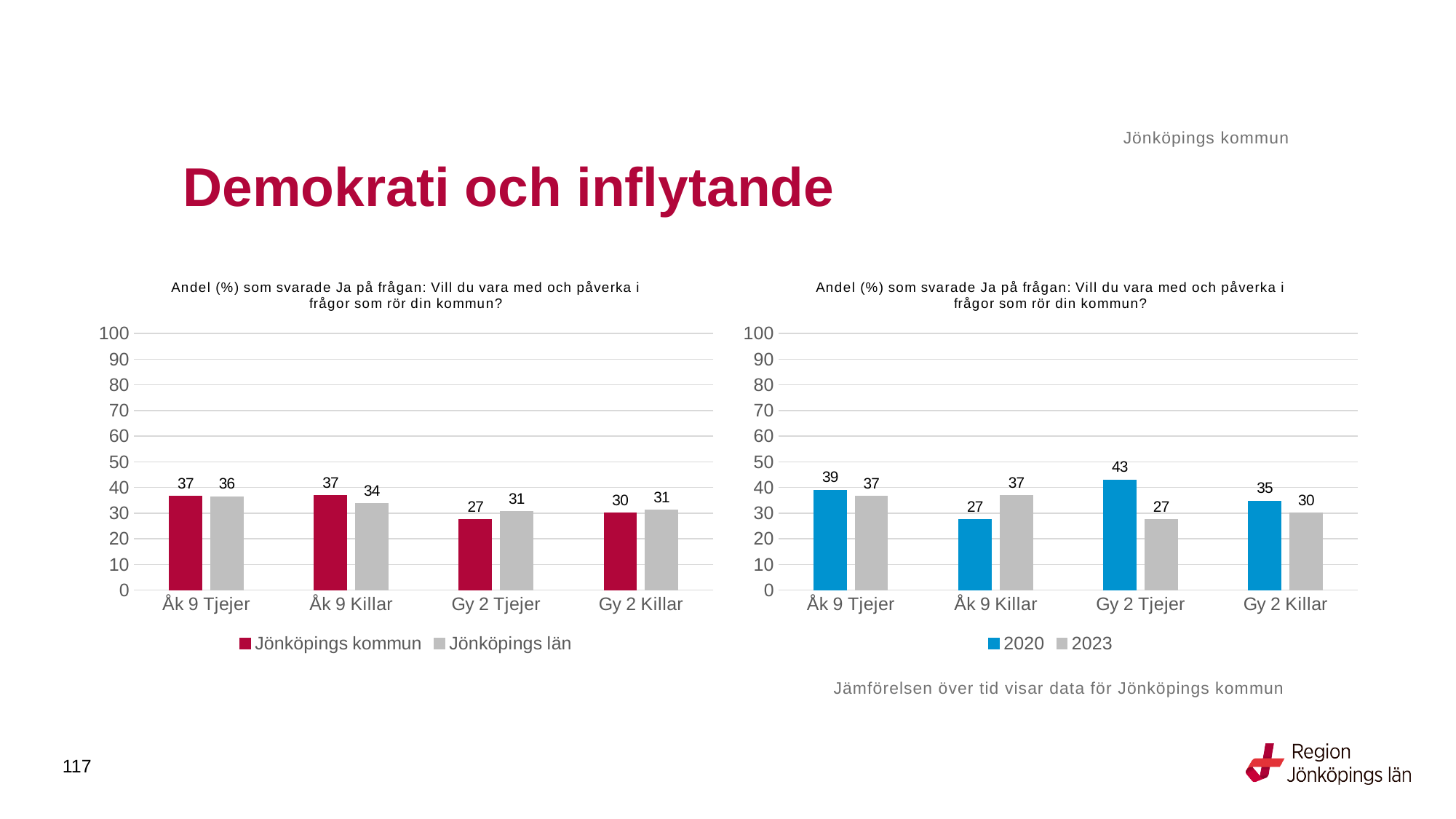
In the right chart, what is the 2020 value for Gy 2 Tjejer? 43 In the left chart, what is the difference between Jönköpings kommun and Jönköpings län for Åk 9 Killar? 3 How many categories are shown on the x axis of the left chart? 4 In the left chart, which category has the lowest Jönköpings kommun value? Gy 2 Tjejer In the left chart, what is the value for Jönköpings län for Gy 2 Tjejer? 31 How many series does the legend of the right chart list? 2 In the right chart, what is the 2023 value for Åk 9 Killar? 37 In the right chart, which category has the highest 2020 value? Gy 2 Tjejer In the right chart, what is the difference between the 2020 and 2023 values for Gy 2 Tjejer? 16 In the right chart, which is larger for Åk 9 Killar: the 2020 value or the 2023 value? 2023 What type of chart is the left chart? Bar chart In the left chart, what is the value for Jönköpings kommun for Åk 9 Tjejer? 37